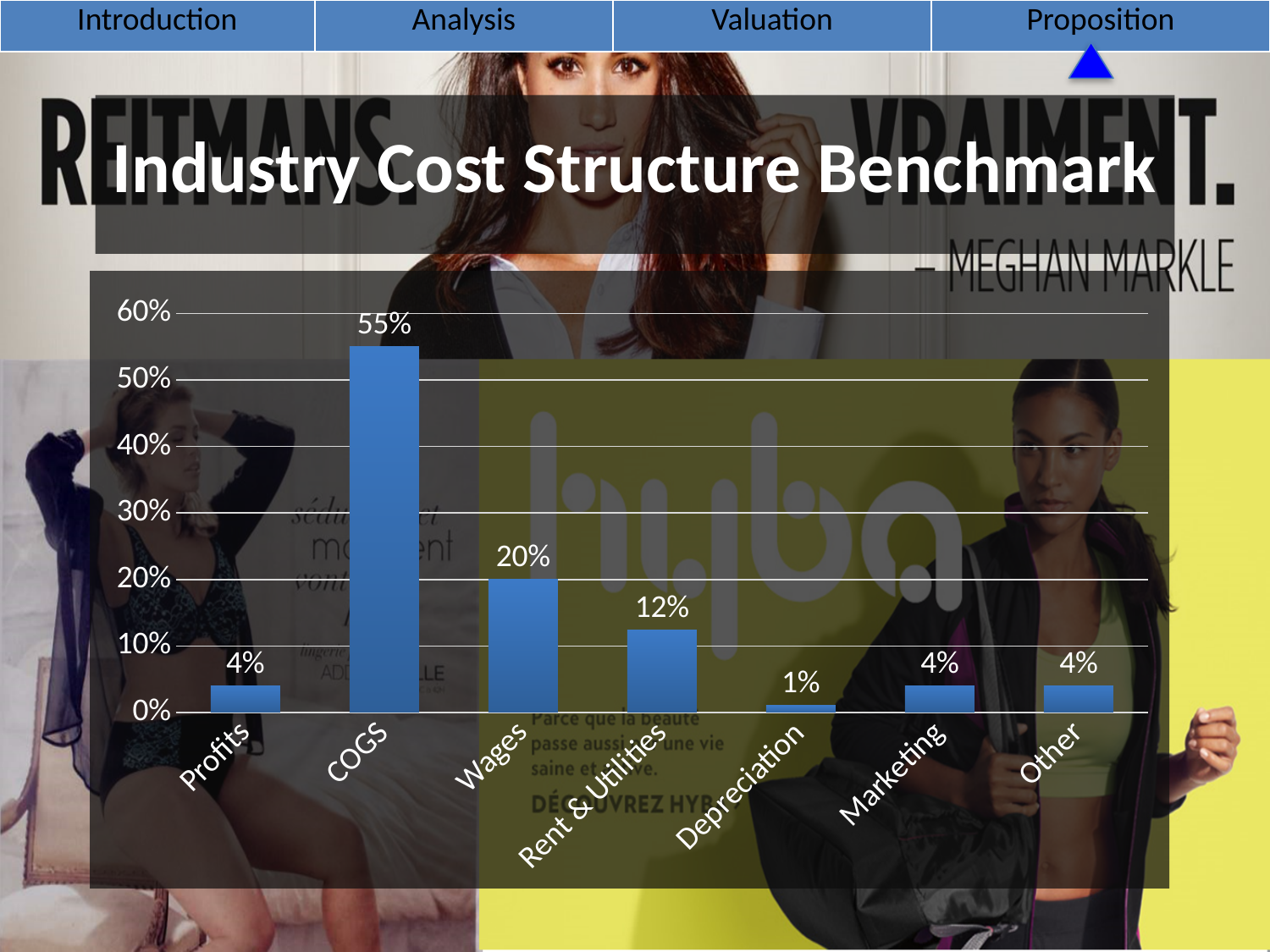
Which category has the lowest value? Depreciation How many categories are shown on the x axis? 7 Which category has the highest value? COGS What is the value for COGS? 55% What is the value for Depreciation? 1% Which is larger, the value for Wages or the value for Rent & Utilities? Wages What kind of chart is shown on the slide? bar chart What is the value for Wages? 20% Is the value for COGS greater or less than 50%? greater What is the title of the slide? Industry Cost Structure Benchmark What is the value for Rent & Utilities? 12% What is the difference between the values for COGS and Wages? 35%